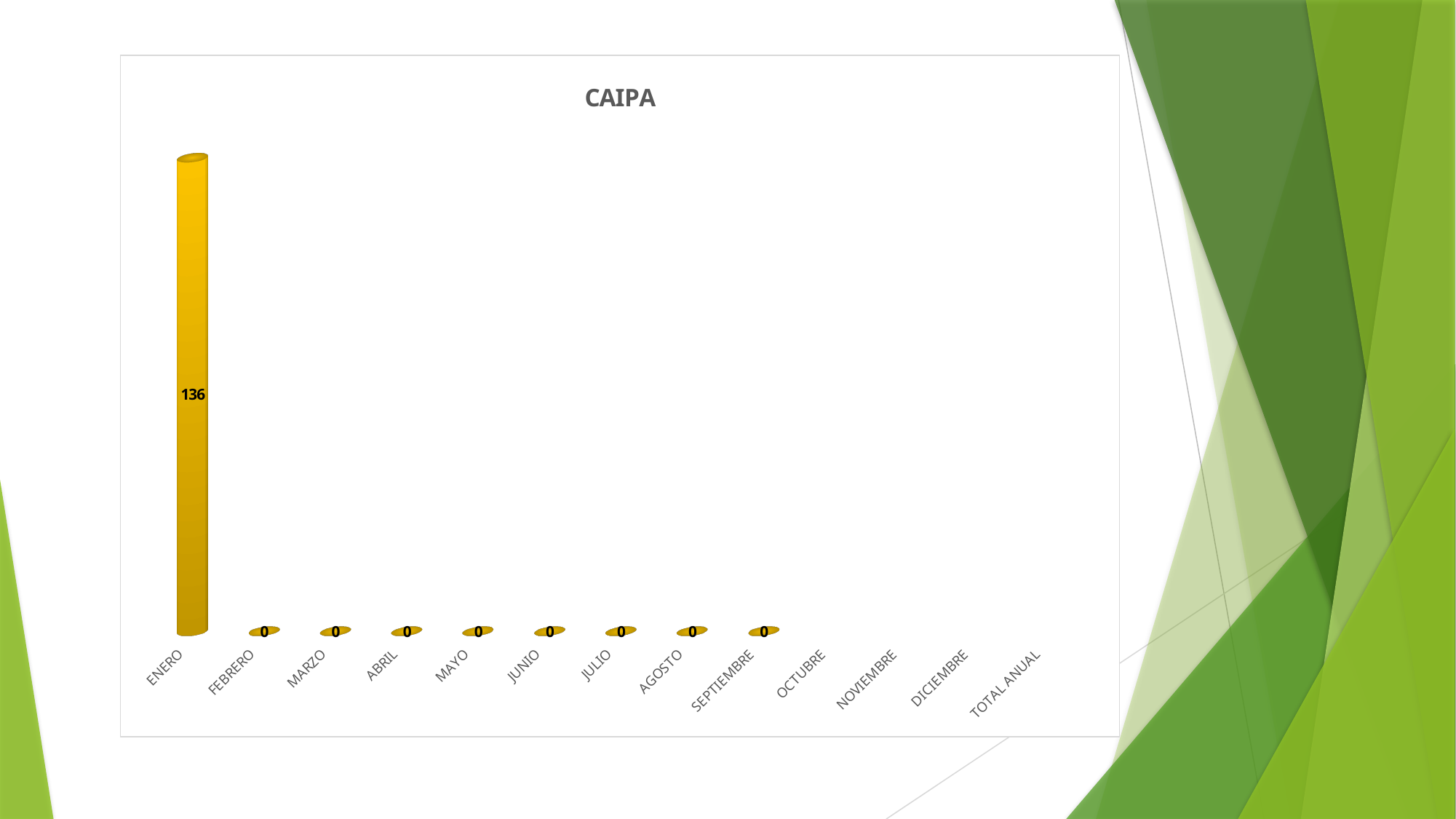
What is the title of the chart on the slide? CAIPA What is the value for SEPTIEMBRE in the CAIPA chart? 0 Which is larger in the CAIPA chart, the value for ENERO or the value for JULIO? ENERO What is the difference between the values for ENERO and MARZO in the CAIPA chart? 136 Which category has the highest value in the CAIPA chart? ENERO What is the value for ENERO in the CAIPA chart? 136 How many categories in the CAIPA chart show a data label of 0? 8 What is the value for FEBRERO in the CAIPA chart? 0 How many categories are shown on the x axis of the CAIPA chart? 13 What colour are the bars in the CAIPA chart? Gold/yellow Do the values rise or fall from ENERO to FEBRERO in the CAIPA chart? Fall What kind of chart is shown on the slide? Bar chart